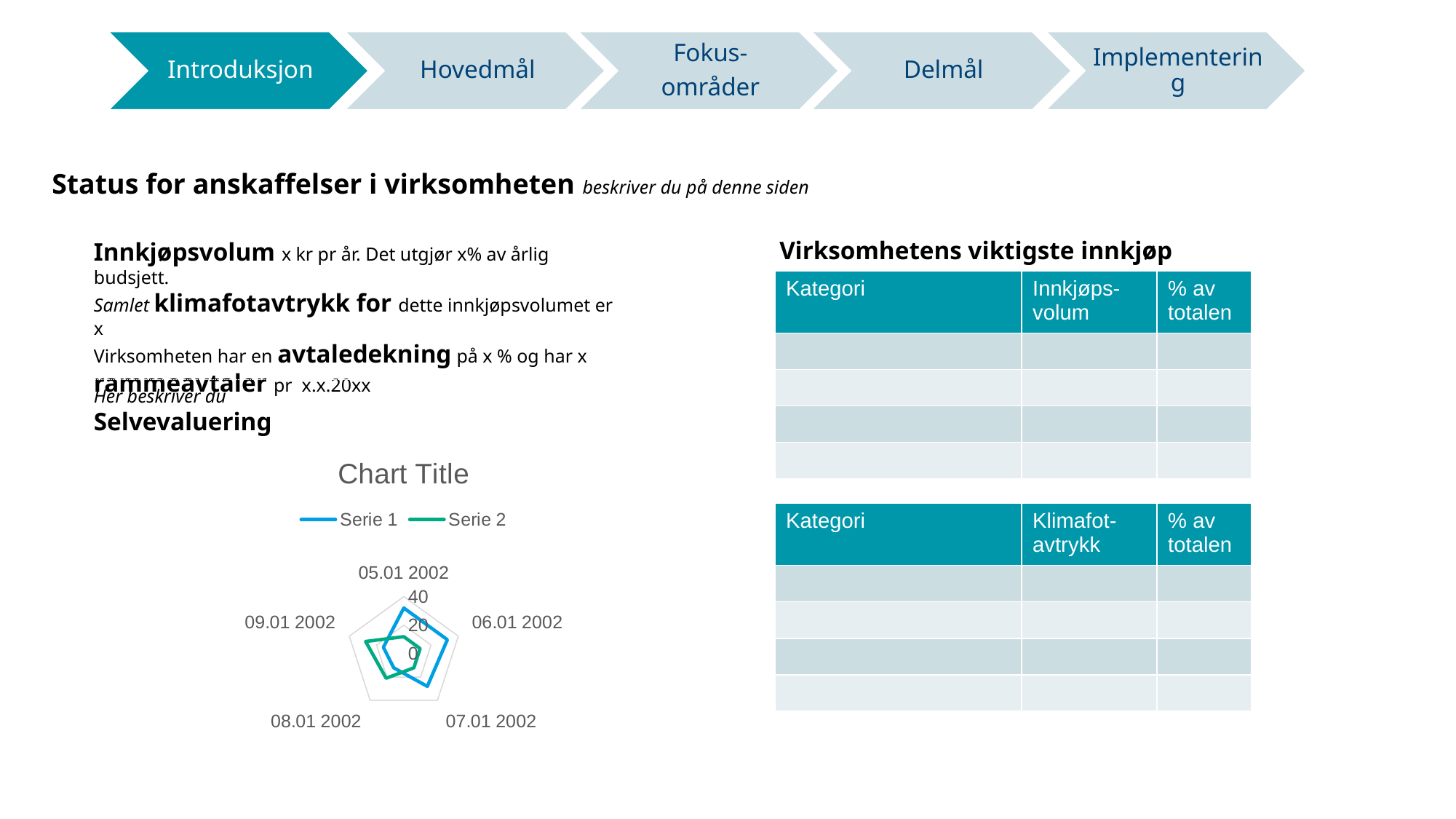
What are the names of the two series in the chart legend? Serie 1 and Serie 2 Is the value of Serie 2 for 05.01 2002 greater or less than 20? less For 09.01 2002, which series has the larger value, Serie 1 or Serie 2? Serie 2 Is the value of Serie 2 for 09.01 2002 greater or less than 20? greater What is the title of the chart? Chart Title How many categories (axes) does the radar chart have? 5 How many series does the chart legend list? 2 Is the value of Serie 1 for 06.01 2002 greater or less than 20? greater What is the highest tick value shown on the chart's value axis? 40 What kind of chart is shown on the slide? Radar chart For 05.01 2002, which series has the larger value, Serie 1 or Serie 2? Serie 1